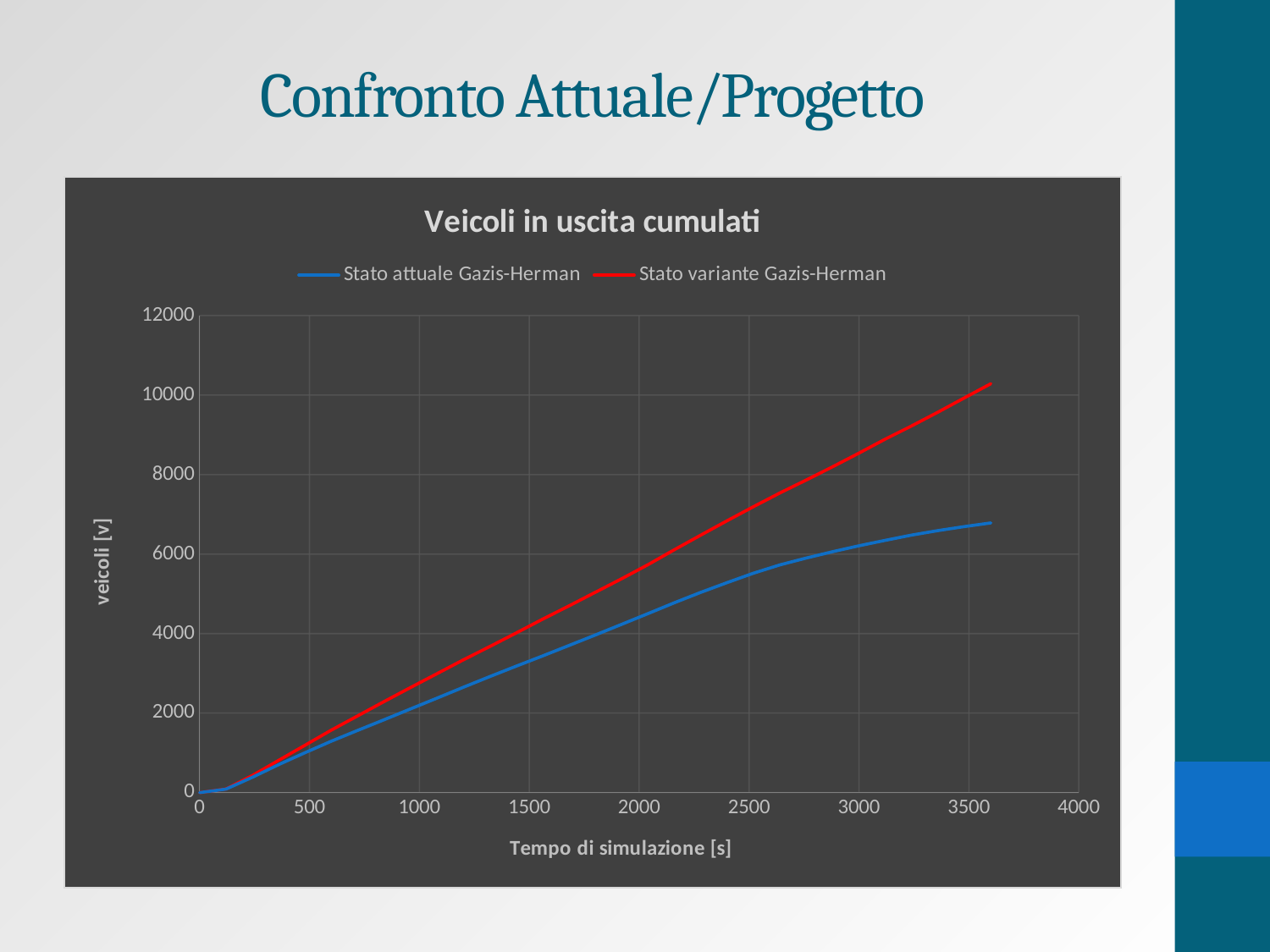
Is the value of 'Stato variante Gazis-Herman' at 2000 s greater or less than 4000? greater At 3000 s, which series has the higher value: 'Stato attuale Gazis-Herman' or 'Stato variante Gazis-Herman'? Stato variante Gazis-Herman Do the values of the 'Stato attuale Gazis-Herman' series rise or fall along the x axis? rise Do the values of the 'Stato variante Gazis-Herman' series rise or fall as the simulation time increases? rise Is the value of 'Stato attuale Gazis-Herman' at 2000 s greater or less than 6000? less What kind of chart is shown on the slide? line chart Is the value of 'Stato attuale Gazis-Herman' at 3500 s greater or less than 8000? less What is the label of the x axis? Tempo di simulazione [s] How many series does the legend list? 2 What is the title of the chart? Veicoli in uscita cumulati Which series reaches the higher value at the end of the simulation? Stato variante Gazis-Herman